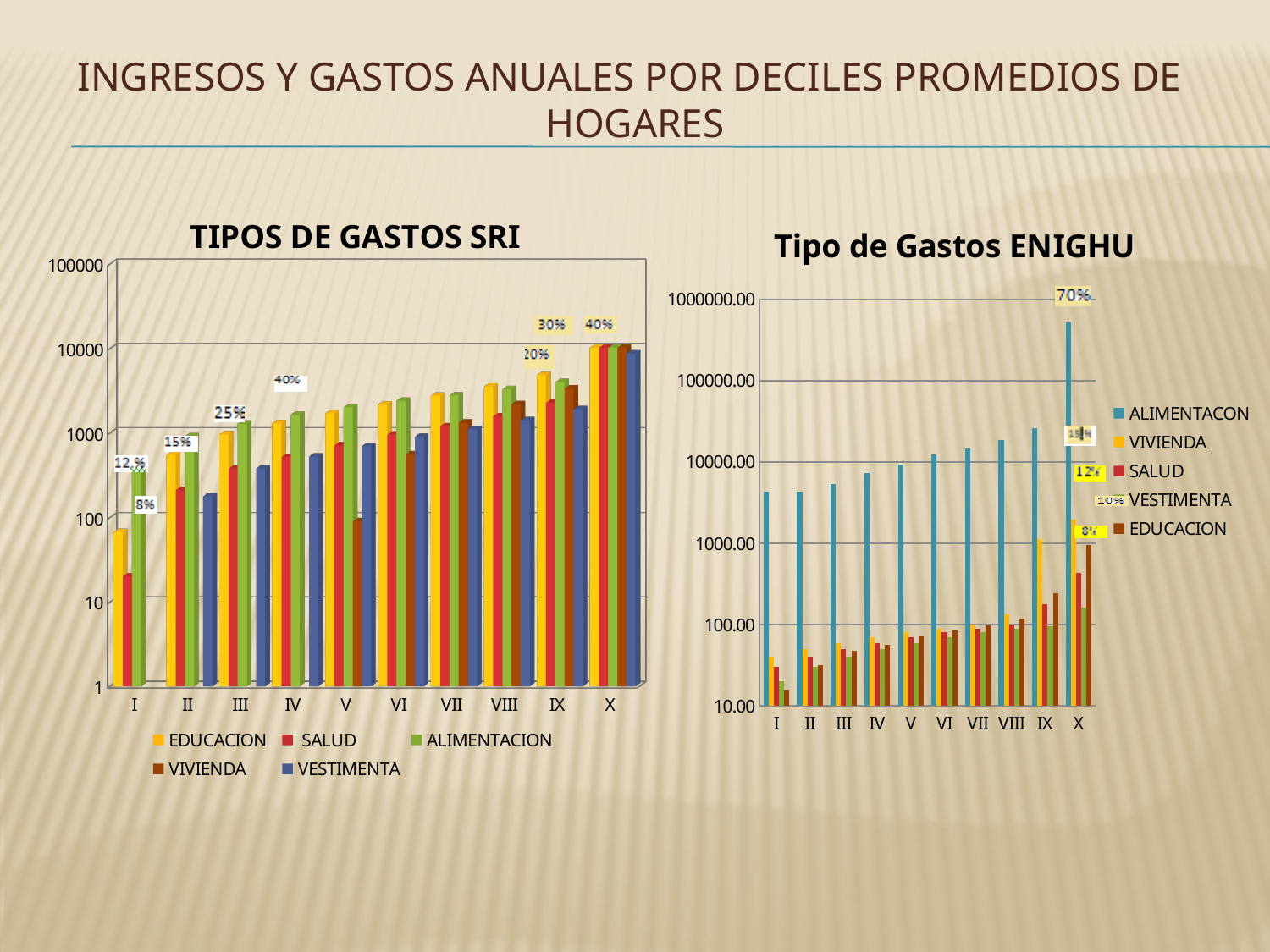
In the "TIPOS DE GASTOS SRI" chart, is the SALUD value for decile I greater or less than 100? less In the "Tipo de Gastos ENIGHU" chart, does the ALIMENTACON series rise or fall from decile I to decile X? rise What is the title of the chart on the right side of the slide? Tipo de Gastos ENIGHU How many series does the legend of the "TIPOS DE GASTOS SRI" chart list? 5 How many series does the legend of the "Tipo de Gastos ENIGHU" chart list? 5 In the "Tipo de Gastos ENIGHU" chart, is the ALIMENTACON value for decile I greater or less than 1000.00? greater How many categories (deciles) are shown on the x axis of the "Tipo de Gastos ENIGHU" chart? 10 In the "Tipo de Gastos ENIGHU" chart, is the ALIMENTACON value for decile X greater or less than 100000.00? greater In the "TIPOS DE GASTOS SRI" chart, which decile has the highest ALIMENTACION value? X In the "TIPOS DE GASTOS SRI" chart, which is larger in decile I: ALIMENTACION or SALUD? ALIMENTACION What kind of chart is the "TIPOS DE GASTOS SRI" chart on the left? bar chart In the "Tipo de Gastos ENIGHU" chart, which series has the highest value in decile X? ALIMENTACON